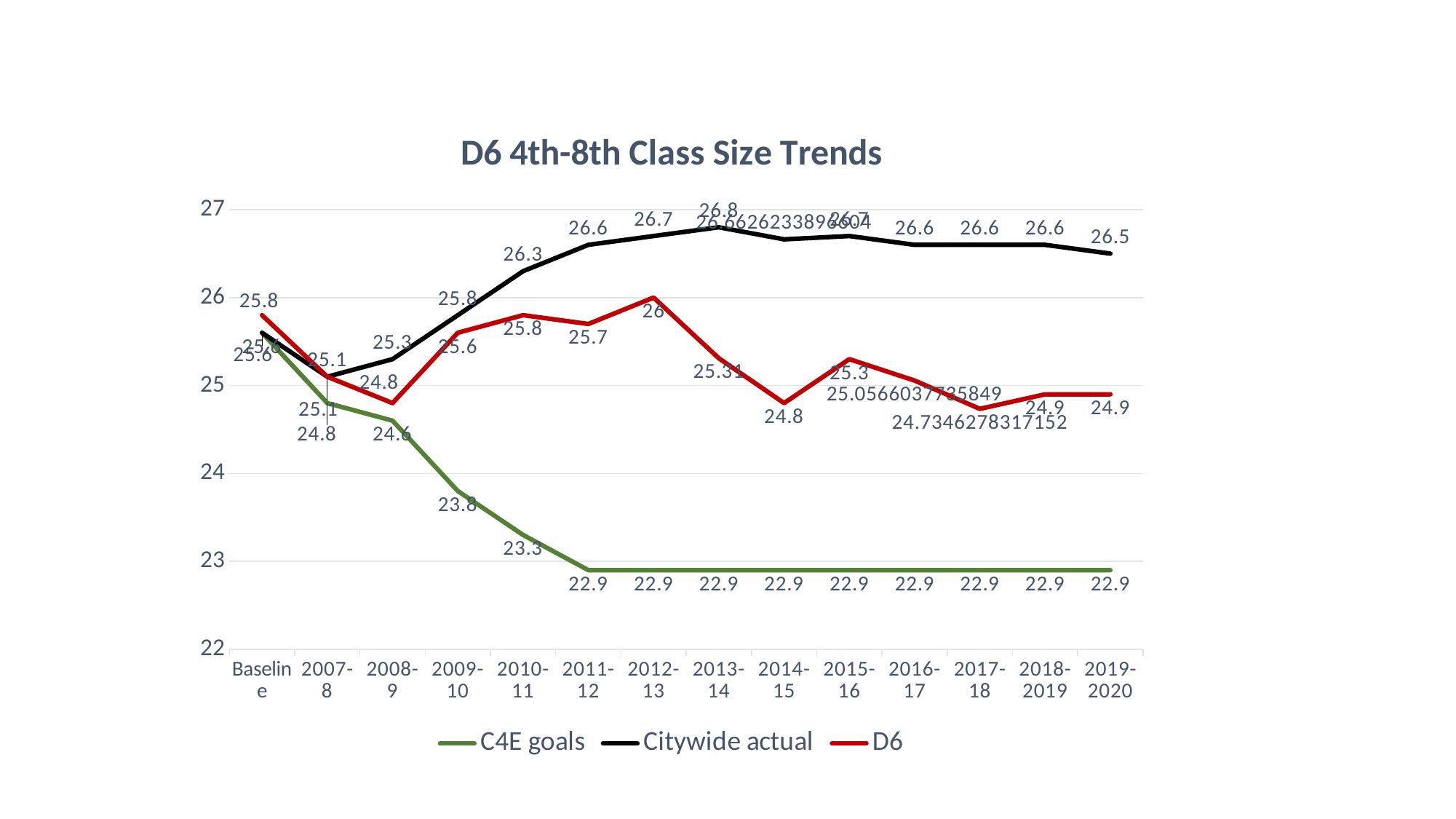
What is the Citywide actual value for 2010-11? 26.3 In which year does the Citywide actual series reach its highest value? 2013-14 For 2012-13, which is larger: the Citywide actual value or the D6 value? Citywide actual Is the D6 value for 2014-15 greater or less than 25? less What is the D6 value for 2012-13? 26 What is the C4E goals value for 2019-2020? 22.9 In which year is the Citywide actual series at its lowest value? 2007-8 How many categories are shown along the x axis? 14 What is the difference between the Citywide actual value and the C4E goals value for 2019-2020? 3.6 What is the title of the chart? D6 4th-8th Class Size Trends What kind of chart is shown on the slide? Line chart How many series does the legend list? 3